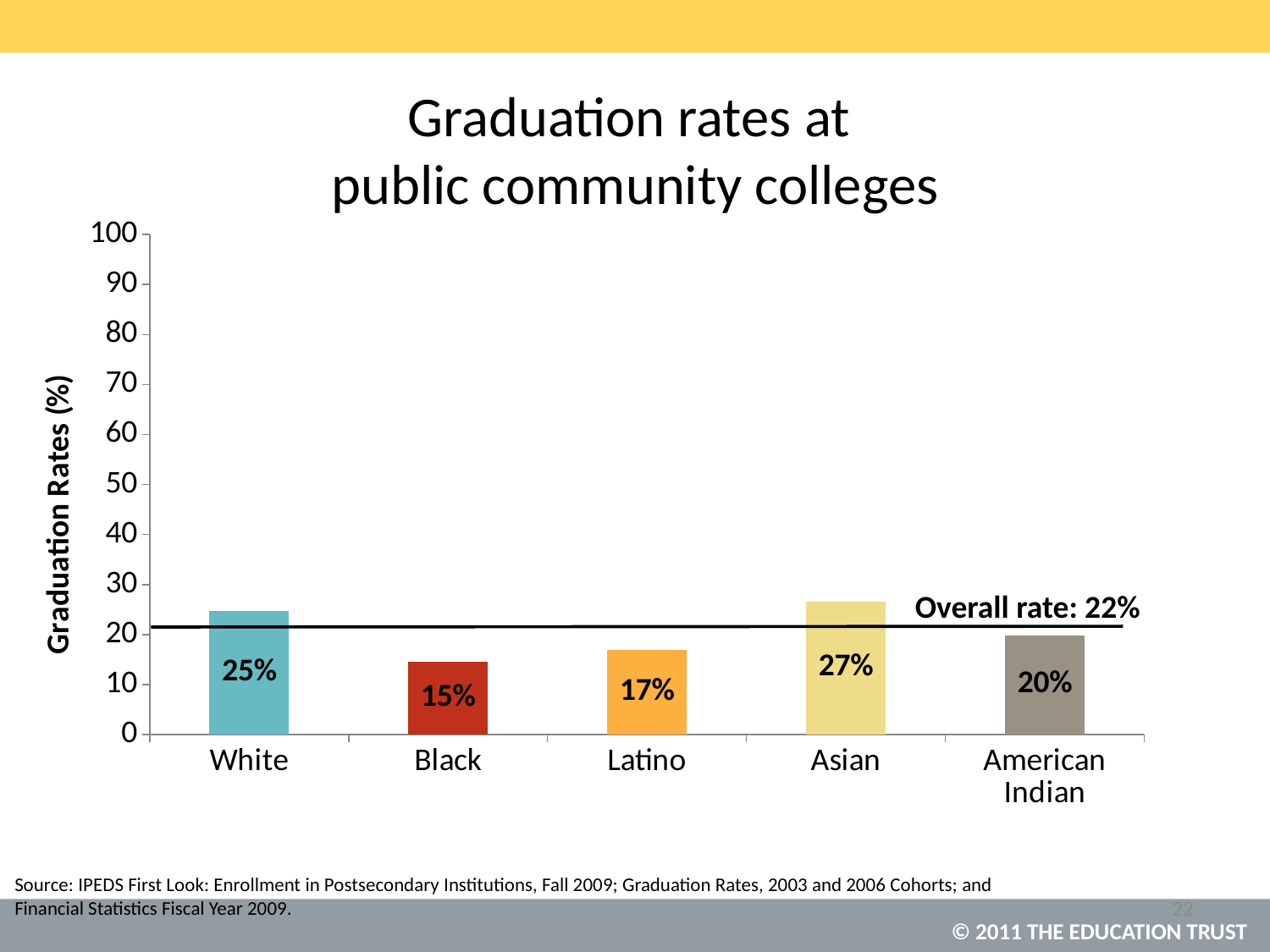
Which group has the lowest graduation rate? Black Which group has the highest graduation rate? Asian What is the difference between the graduation rates for Asian and Black students? 12% Which is larger, the graduation rate for Latino students or for American Indian students? American Indian How many groups are shown on the x axis? 5 What is the label of the y axis? Graduation Rates (%) What overall rate is marked by the horizontal line on the chart? 22% What kind of chart is shown on the slide? Bar chart What is the difference between the graduation rates for White and Latino students? 8% What is the graduation rate for Black students? 15% What is the graduation rate for American Indian students? 20% What is the graduation rate for White students? 25%